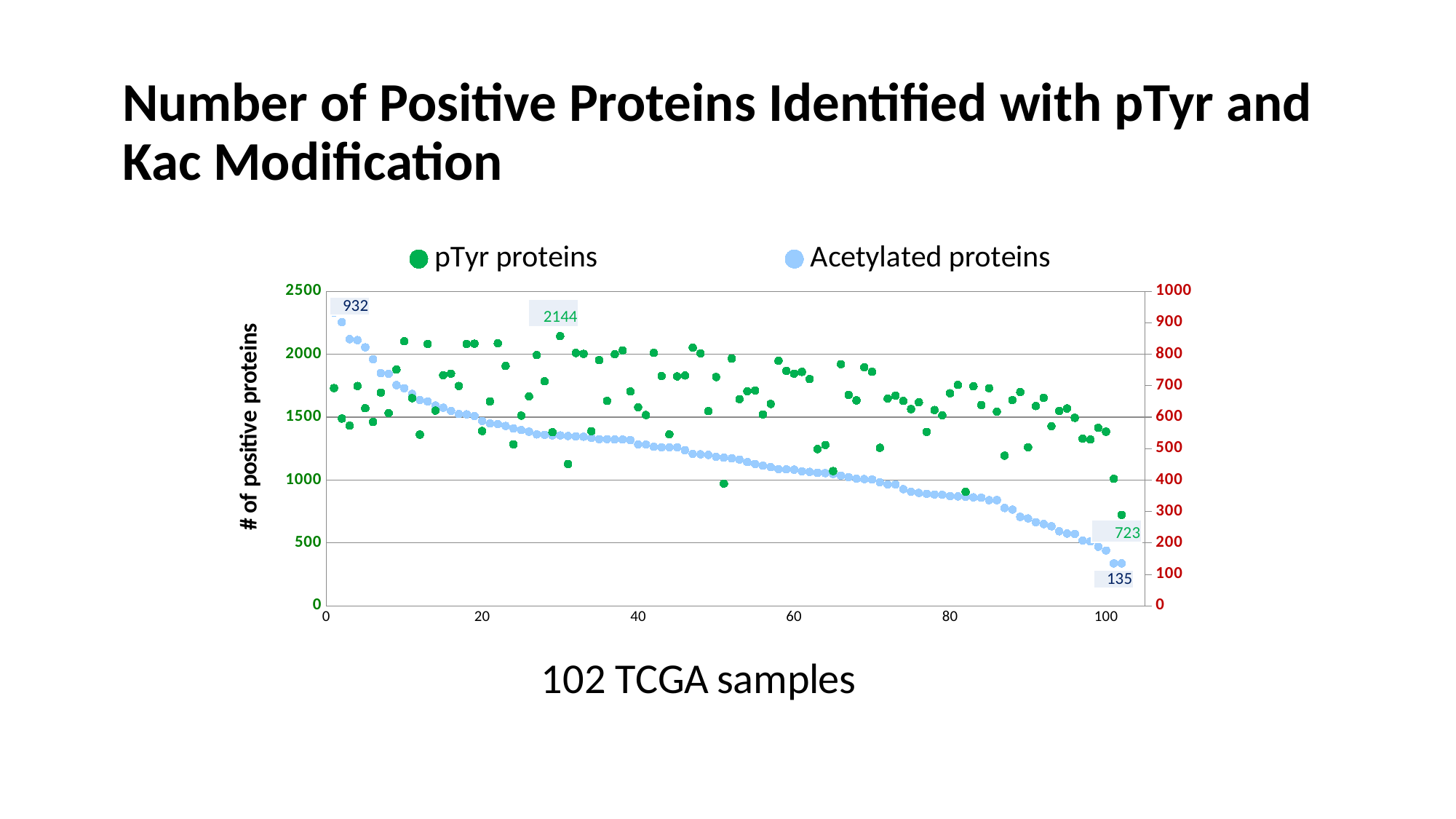
Do the Acetylated proteins values rise or fall along the x axis? fall How many TCGA samples are plotted according to the x-axis label? 102 What is the label of the left vertical axis? # of positive proteins How many series does the legend list? 2 What is the difference between the highest and lowest labelled pTyr proteins values? 1421 What kind of chart is shown on the slide? scatter chart What is the lowest labelled value for Acetylated proteins? 135 What is the highest labelled value for pTyr proteins? 2144 What is the difference between the highest and lowest labelled Acetylated proteins values? 797 What is the highest labelled value for Acetylated proteins? 932 What is the lowest labelled value for pTyr proteins? 723 Which is larger, the highest labelled pTyr proteins value or the highest labelled Acetylated proteins value? pTyr proteins